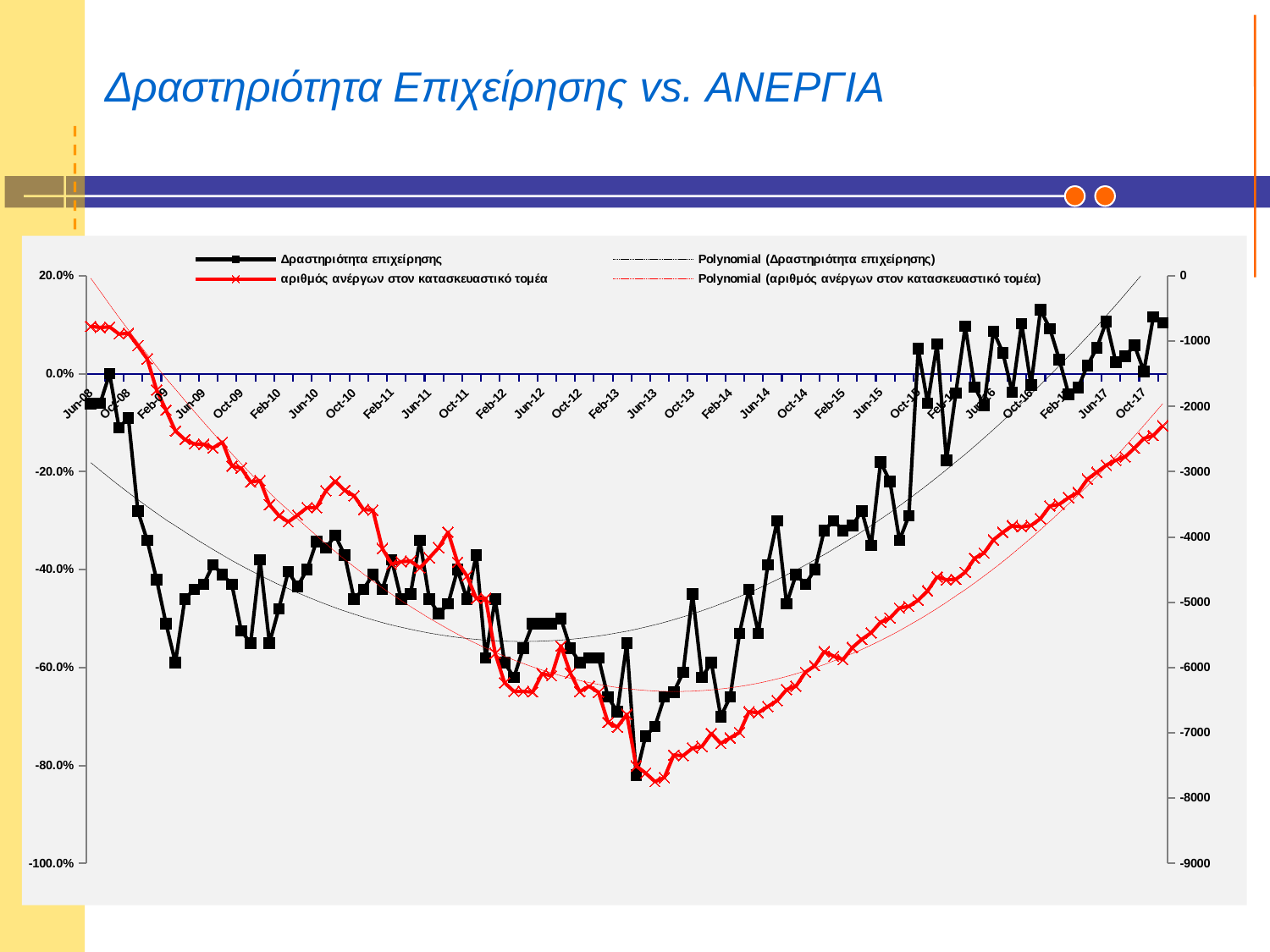
Is the value of the 'αριθμός ανέργων στον κατασκευαστικό τομέα' series at Jun-08 greater or less than -1000 on the right axis? greater Does the 'αριθμός ανέργων στον κατασκευαστικό τομέα' series generally rise or fall between Jun-08 and Jun-13? fall Is the value of the 'αριθμός ανέργων στον κατασκευαστικό τομέα' series at Jun-13 greater or less than -7000 on the right axis? less What kind of chart is shown on the slide? line chart Which colour is used for the series 'αριθμός ανέργων στον κατασκευαστικό τομέα'? red What is the title of the slide containing the chart? Δραστηριότητα Επιχείρησης vs. ΑΝΕΡΓΙΑ Is the value of the 'Δραστηριότητα επιχείρησης' series at Feb-09 greater or less than -40.0%? less Does the 'Δραστηριότητα επιχείρησης' series generally rise or fall between Jun-13 and Oct-17? rise How many entries does the chart legend list? 4